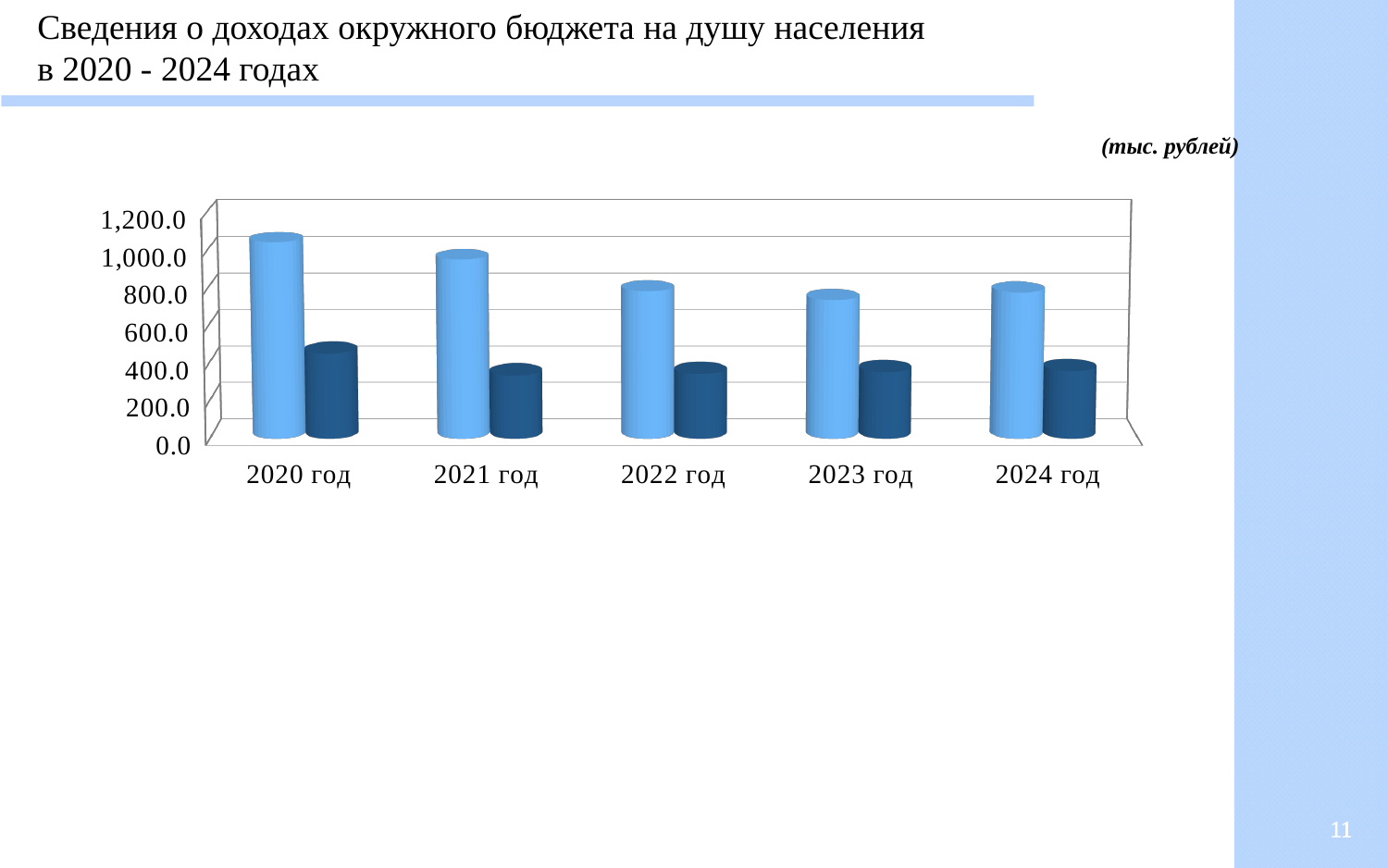
How many year categories are shown on the x axis of the chart? 5 Which year has the tallest light blue bar? 2020 год Do the light blue bars rise or fall from 2020 год to 2022 год? Fall Is the dark blue bar for 2021 год greater or less than 200.0? greater Is the light blue bar for 2020 год greater or less than 800.0? greater How many series (bar colours) are plotted for each year in the chart? 2 What kind of chart is shown on the slide? Bar chart Is the dark blue bar for 2020 год greater or less than 600.0? less In 2020 год, which bar is taller, the light blue one or the dark blue one? The light blue one Which year has the tallest dark blue bar? 2020 год What unit is indicated for the values in the chart? тыс. рублей